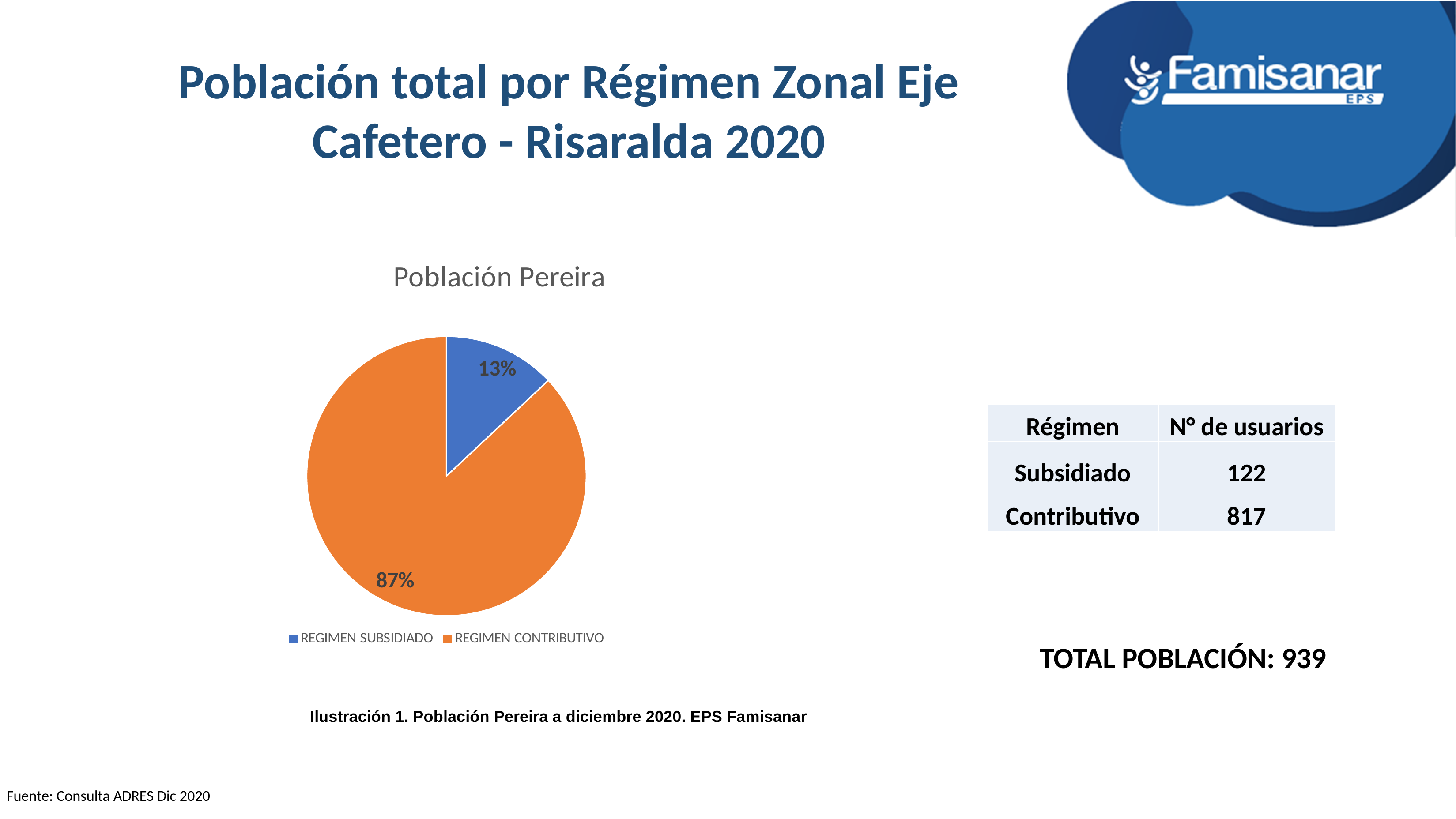
What is the difference in percentage points between the REGIMEN CONTRIBUTIVO and REGIMEN SUBSIDIADO slices? 74% What share of the pie does REGIMEN SUBSIDIADO represent? 13% What is the title of the chart? Población Pereira What share of the pie does REGIMEN CONTRIBUTIVO represent? 87% Which slice of the pie is the largest? REGIMEN CONTRIBUTIVO What colour is the REGIMEN SUBSIDIADO slice? blue What type of chart is shown on the slide? pie chart Which is larger, the REGIMEN SUBSIDIADO slice or the REGIMEN CONTRIBUTIVO slice? REGIMEN CONTRIBUTIVO How many entries does the legend list? 2 Which slice of the pie is the smallest? REGIMEN SUBSIDIADO How many slices does the pie chart have? 2